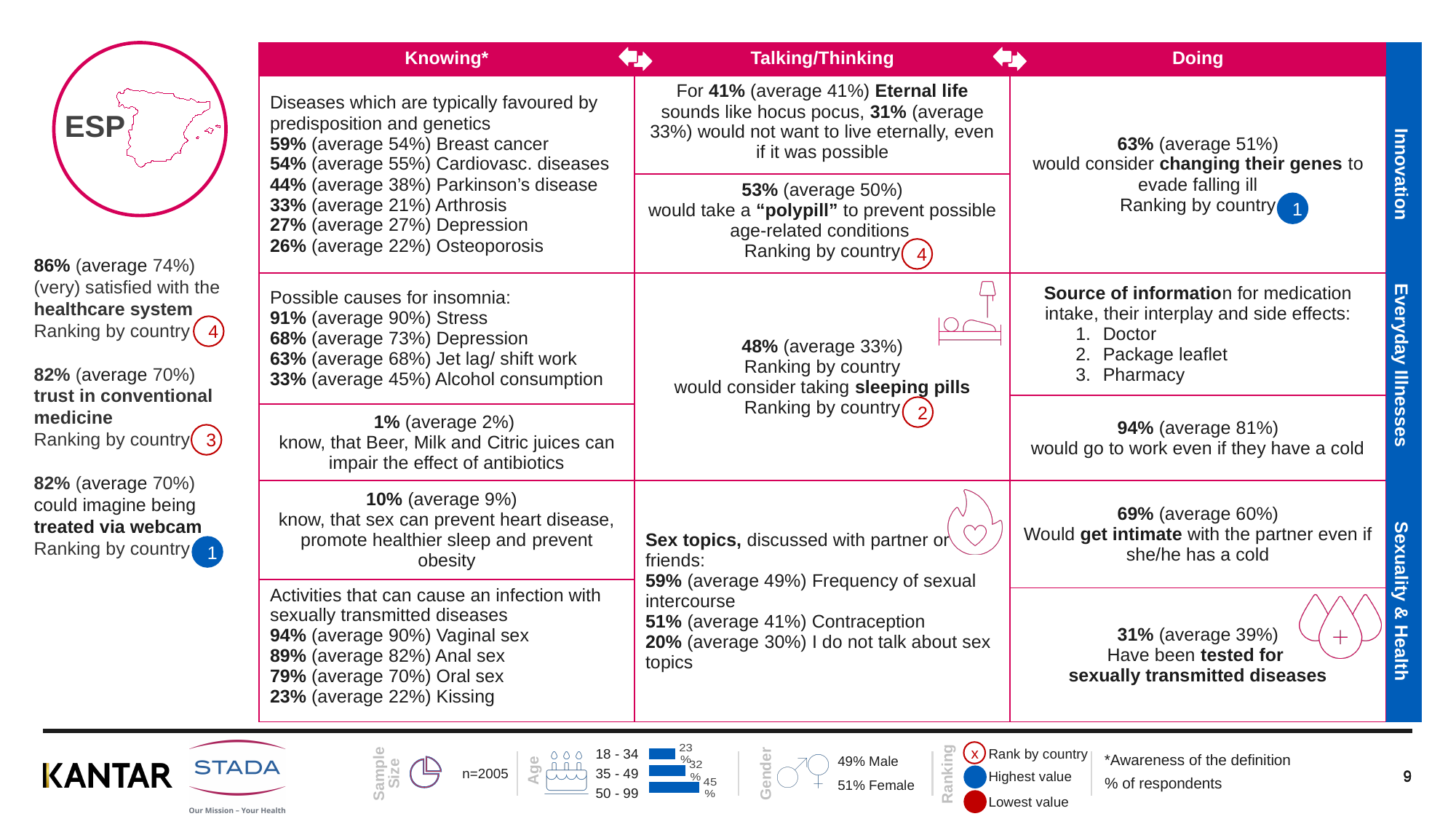
What kind of chart is used to show the age distribution at the bottom of the slide? Bar chart In the Age bar chart at the bottom of the slide, what do the three age group percentages add up to? 100% In the Age bar chart at the bottom of the slide, which age group has the lowest share of respondents? 18 - 34 In the Age bar chart at the bottom of the slide, what percentage of respondents are aged 35 - 49? 32% In the Age bar chart at the bottom of the slide, what percentage of respondents are aged 18 - 34? 23% In the Age bar chart at the bottom of the slide, what percentage of respondents are aged 50 - 99? 45% In the Age bar chart at the bottom of the slide, do the values rise or fall as the age groups get older? Rise In the Age bar chart at the bottom of the slide, which age group has the highest share of respondents? 50 - 99 How many age groups are shown in the Age bar chart at the bottom of the slide? 3 In the Age bar chart at the bottom of the slide, which is larger: the 35 - 49 group or the 18 - 34 group? 35 - 49 In the Age bar chart at the bottom of the slide, how many percentage points larger is the 50 - 99 group than the 18 - 34 group? 22 percentage points What is the sample size (n) shown next to the Age bar chart at the bottom of the slide? n=2005